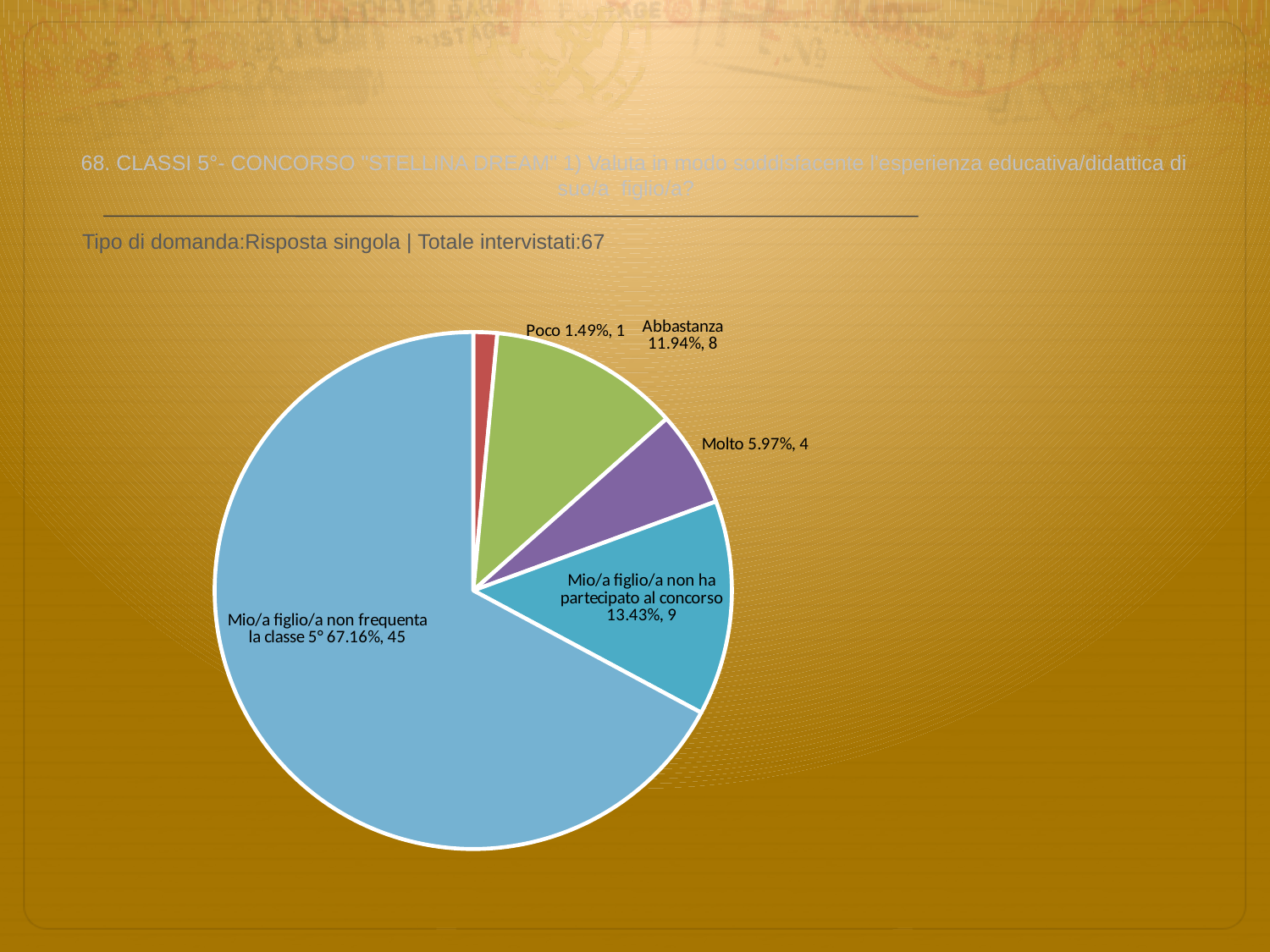
What share of the pie does "Mio/a figlio/a non frequenta la classe 5°" represent? 67.16% What is the total number of respondents stated on the slide? 67 Which slice is the largest in the pie chart? Mio/a figlio/a non frequenta la classe 5° How many respondents answered "Poco"? 1 Which has more respondents, "Molto" or "Abbastanza"? Abbastanza How many slices does the pie chart have? 5 How many respondents answered "Abbastanza"? 8 Which slice is the smallest in the pie chart? Poco What kind of chart is shown on the slide? pie chart What is the difference in count between "Mio/a figlio/a non ha partecipato al concorso" and "Abbastanza"? 1 What percentage is shown for "Mio/a figlio/a non ha partecipato al concorso"? 13.43% What percentage is shown for the "Molto" slice? 5.97%